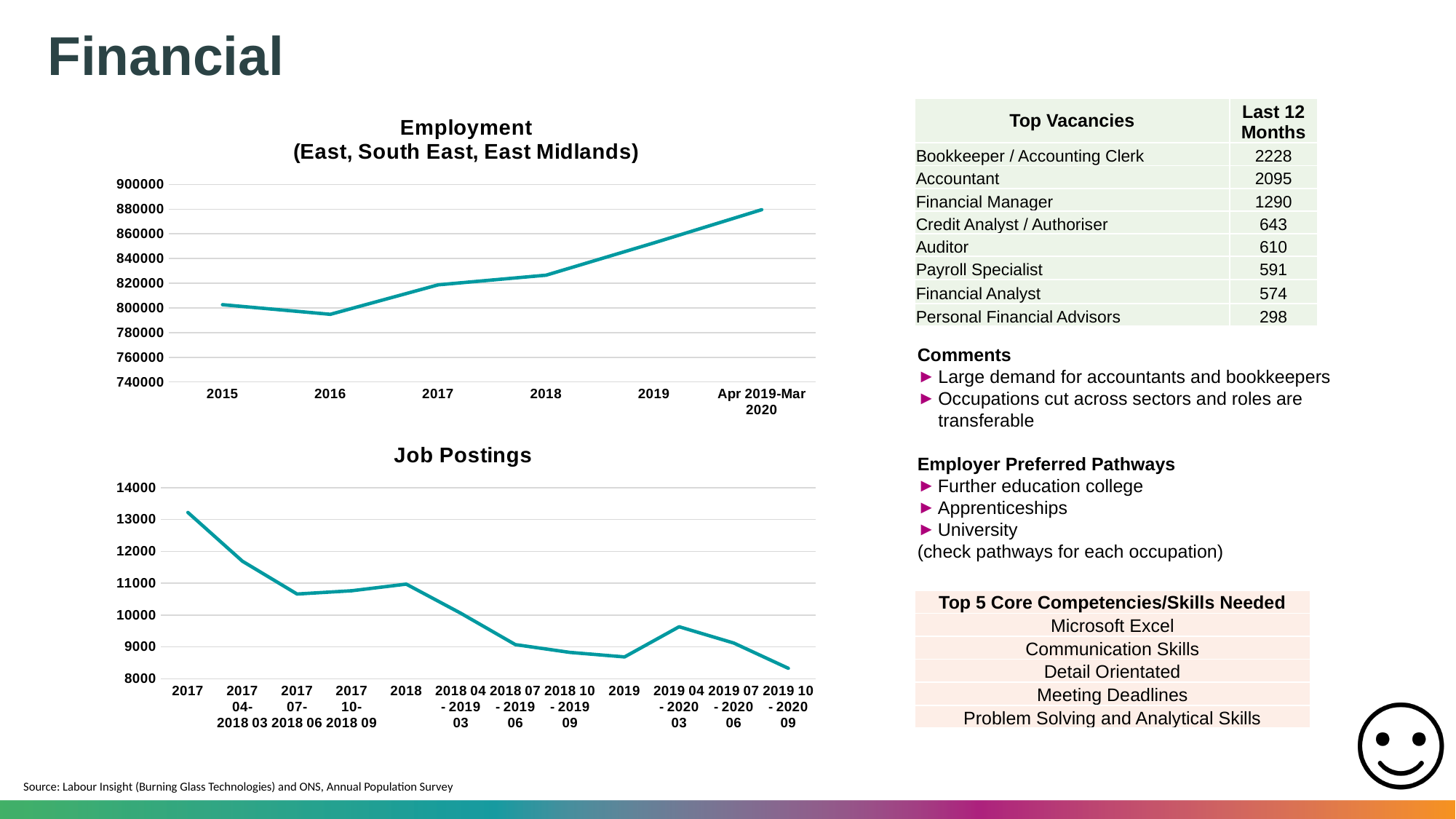
What kind of chart is the Job Postings chart? line chart On the Employment (East, South East, East Midlands) chart, is the value for 2019 greater or less than 840000? greater On the Employment (East, South East, East Midlands) chart, is employment higher in 2018 or in 2015? 2018 On the Job Postings chart, do job postings generally rise or fall from 2017 to 2019 10 - 2020 09? fall On the Employment (East, South East, East Midlands) chart, which year has the lowest employment? 2016 What kind of chart is the Employment (East, South East, East Midlands) chart? line chart On the Employment (East, South East, East Midlands) chart, which period has the highest employment? Apr 2019-Mar 2020 On the Employment (East, South East, East Midlands) chart, is the value for 2016 greater or less than 800000? less How many data points are plotted on the Job Postings chart? 12 On the Job Postings chart, is the value for 2019 04 - 2020 03 greater or less than 9000? greater How many data points are plotted on the Employment (East, South East, East Midlands) chart? 6 On the Job Postings chart, which period has the highest number of job postings? 2017